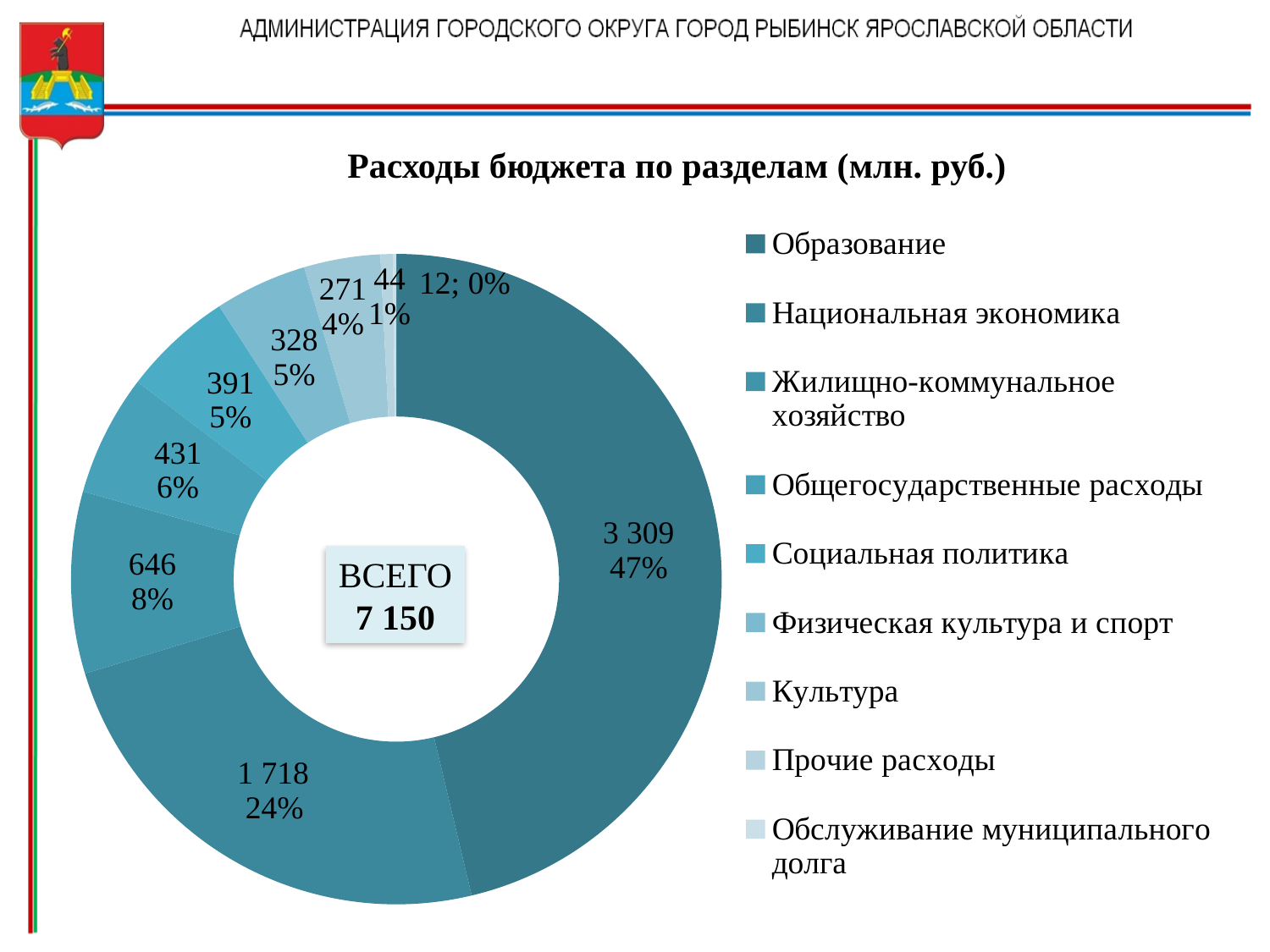
What is the total of all budget expenses shown in the centre of the chart? 7 150 What share of the budget expenses does Национальная экономика account for? 24% Which is larger: Общегосударственные расходы or Социальная политика? Общегосударственные расходы Which section has the smallest budget expenses? Обслуживание муниципального долга What is the title of the chart? Расходы бюджета по разделам (млн. руб.) What is the difference between the values for Образование and Национальная экономика? 1 591 What is the value for Образование in the chart? 3 309 What share of the budget expenses does Физическая культура и спорт account for? 5% How many sections (categories) does the chart show? 9 What is the value for Жилищно-коммунальное хозяйство? 646 What type of chart is shown on the slide? Doughnut (pie) chart Which section has the largest budget expenses? Образование